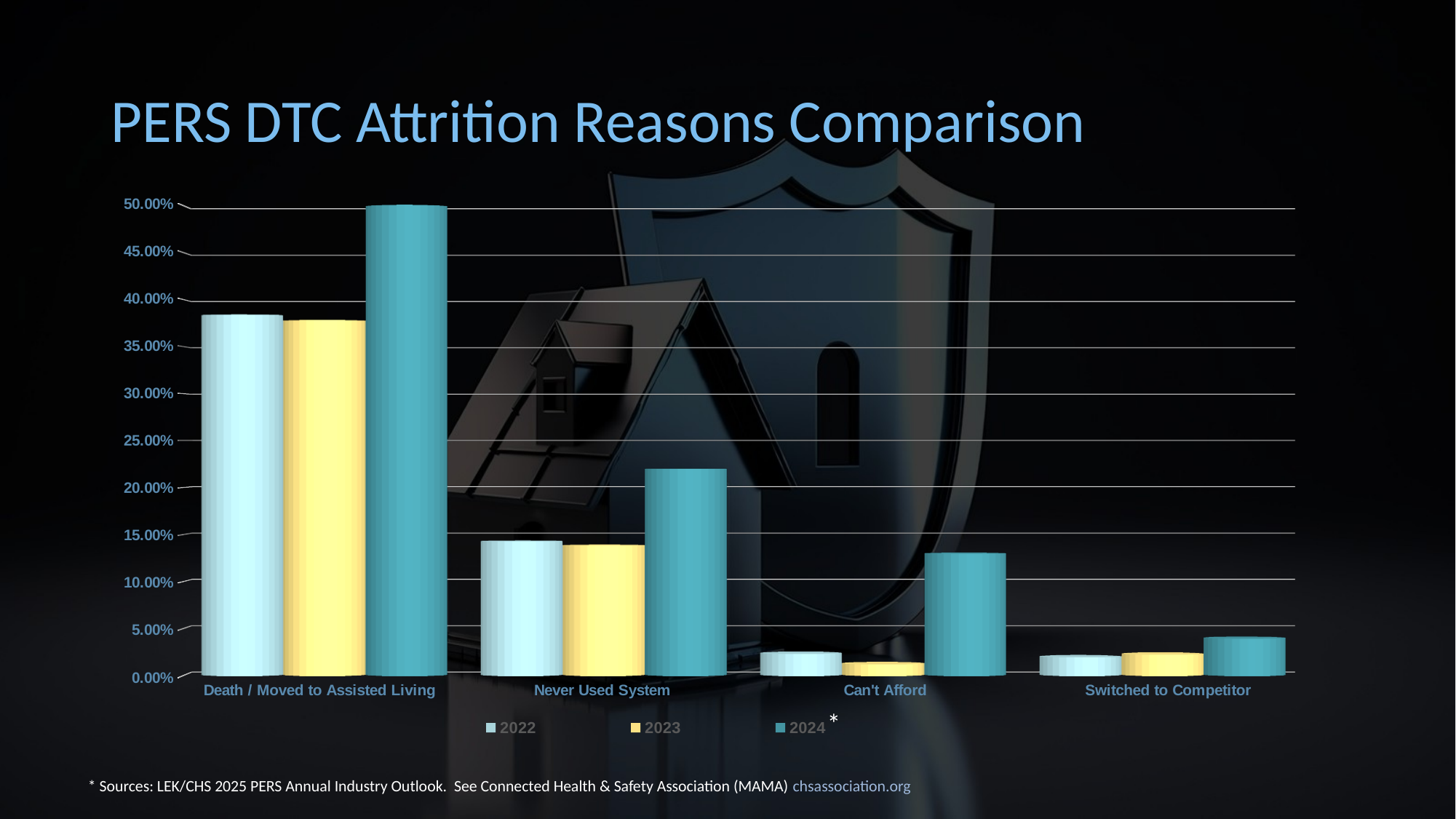
What is the title of the chart? PERS DTC Attrition Reasons Comparison Which category has the lowest value for the 2024 series? Switched to Competitor What kind of chart is shown on the slide? bar chart Which category has the highest bars overall? Death / Moved to Assisted Living For Can't Afford, which series has the larger value, 2023 or 2024? 2024 How many series does the legend list? 3 Is the 2024 value for Switched to Competitor greater or less than 5.00%? less Which category has the lowest value for the 2023 series? Can't Afford Is the 2024 value for Never Used System greater or less than 20.00%? greater Which series is shown in yellow in the legend? 2023 How many attrition reason categories are shown on the x axis? 4 Is the 2022 value for Death / Moved to Assisted Living greater or less than 35.00%? greater